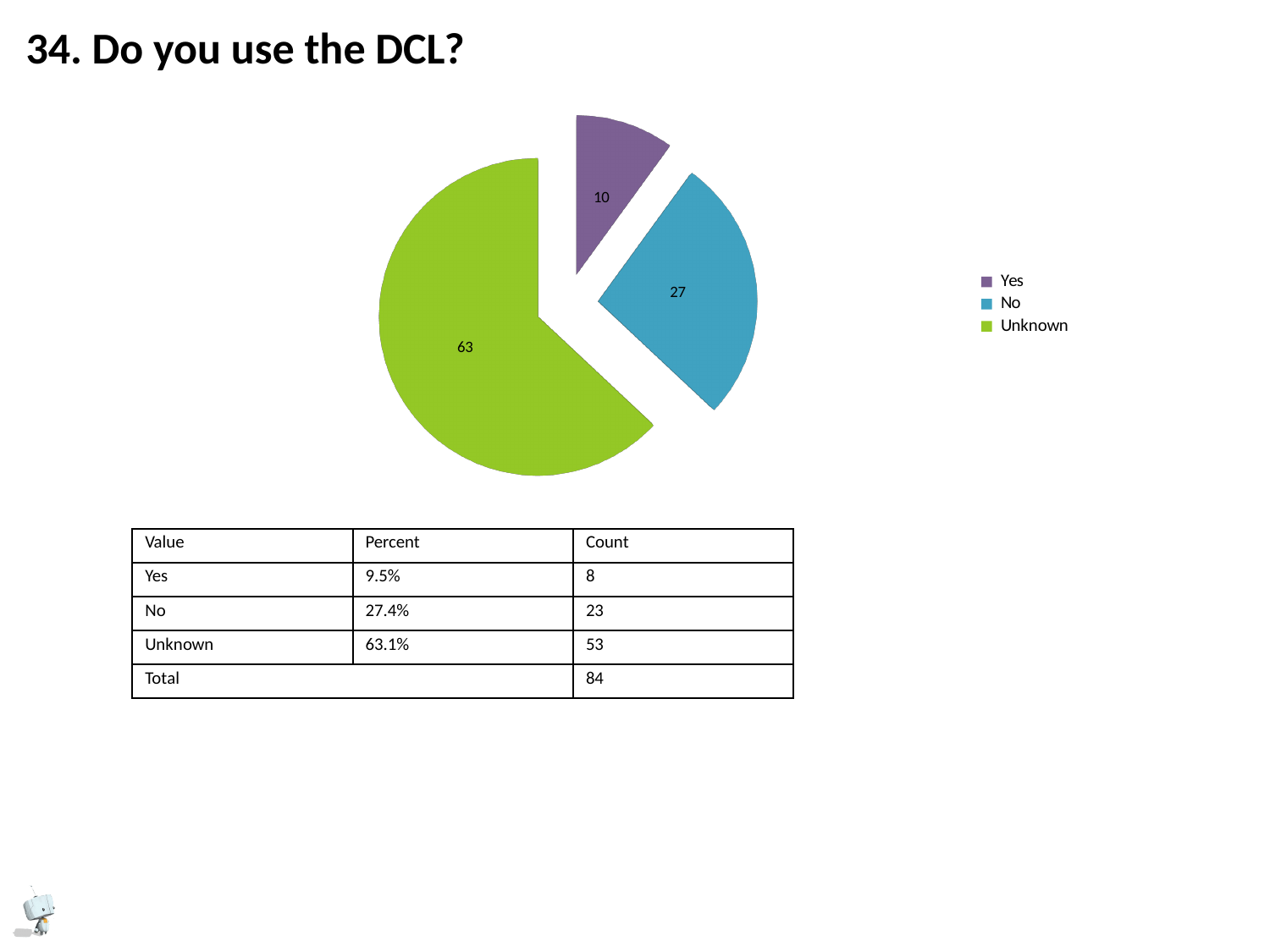
What type of chart is shown on the slide? pie chart What is the difference between the data labels of the Unknown and No slices in the pie chart? 36 What is the data label shown on the Yes slice of the pie chart? 10 How many entries does the legend of the pie chart list? 3 What colour is the Unknown slice in the pie chart? green What is the data label shown on the Unknown slice of the pie chart? 63 What is the data label shown on the No slice of the pie chart? 27 How many slices does the pie chart have? 3 What is the difference between the data labels of the No and Yes slices in the pie chart? 17 Which category has the largest slice in the pie chart? Unknown Which slice is larger in the pie chart, No or Yes? No Which category has the smallest slice in the pie chart? Yes